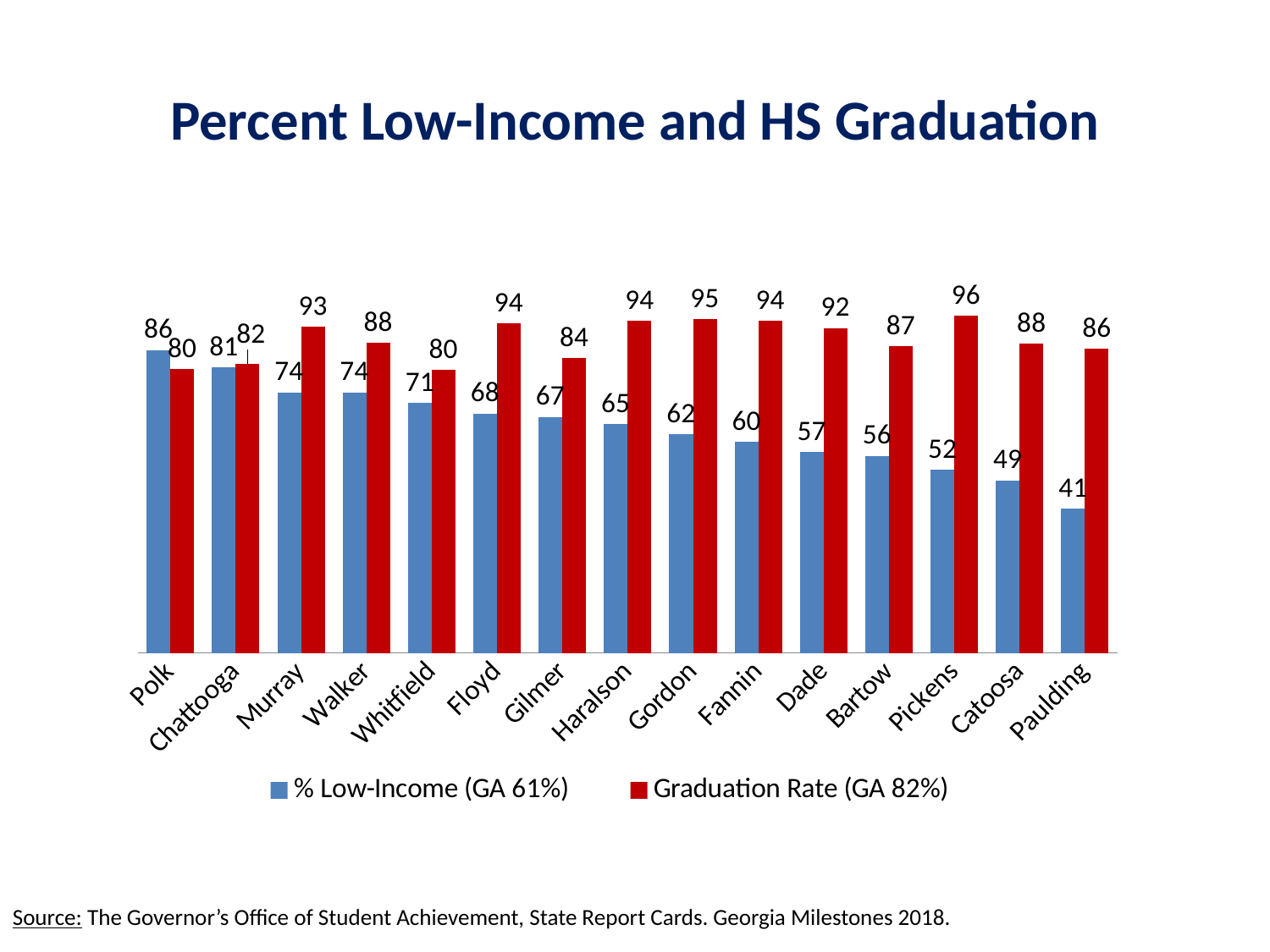
What is the difference between the Graduation Rate and the % Low-Income value for Pickens? 44 What is the % Low-Income value for Paulding? 41 What is the % Low-Income value for Gordon? 62 What type of chart is shown on the slide? Bar chart How many counties are shown on the x axis? 15 Which county has the highest % Low-Income value? Polk What is the Graduation Rate for Floyd? 94 Which county has the lowest % Low-Income value? Paulding Which county has the highest Graduation Rate? Pickens How many series does the legend list? 2 What is the difference between the Graduation Rate for Murray and the Graduation Rate for Walker? 5 Which is larger for Polk: the % Low-Income value or the Graduation Rate? % Low-Income